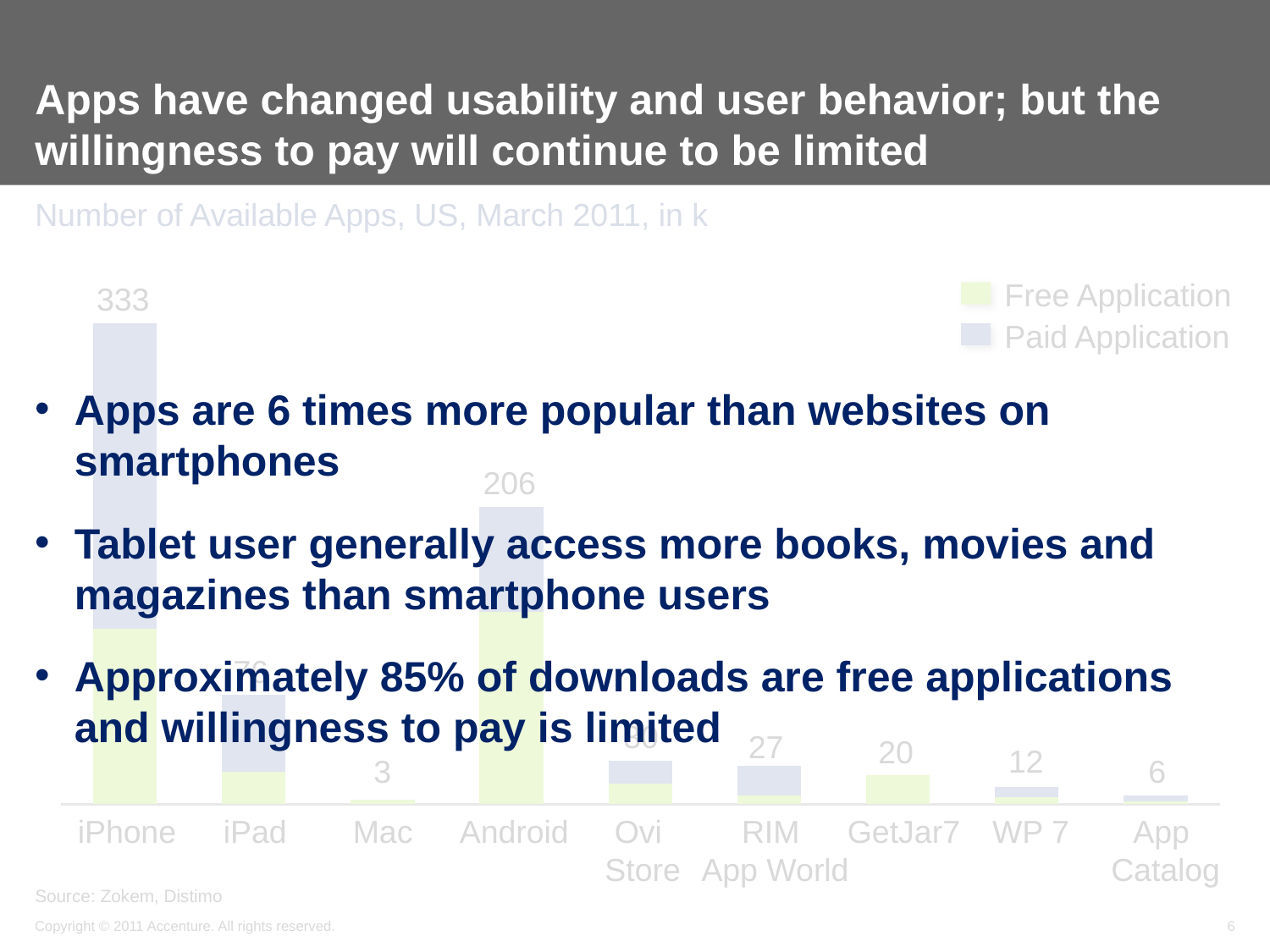
What value is shown for Mac? 3 How many series does the legend list? 2 What is the difference between the iPhone and Android totals? 127 What value is shown for App Catalog? 6 What value is shown for RIM App World? 27 Which has more available apps, GetJar7 or WP 7? GetJar7 What is the total number of available apps shown for iPhone? 333 What type of chart is shown on the slide? Stacked bar chart Which platform has the highest number of available apps? iPhone What is the total number of available apps shown for Android? 206 Which platform has the lowest number of available apps? Mac How many platforms are shown on the x axis? 9